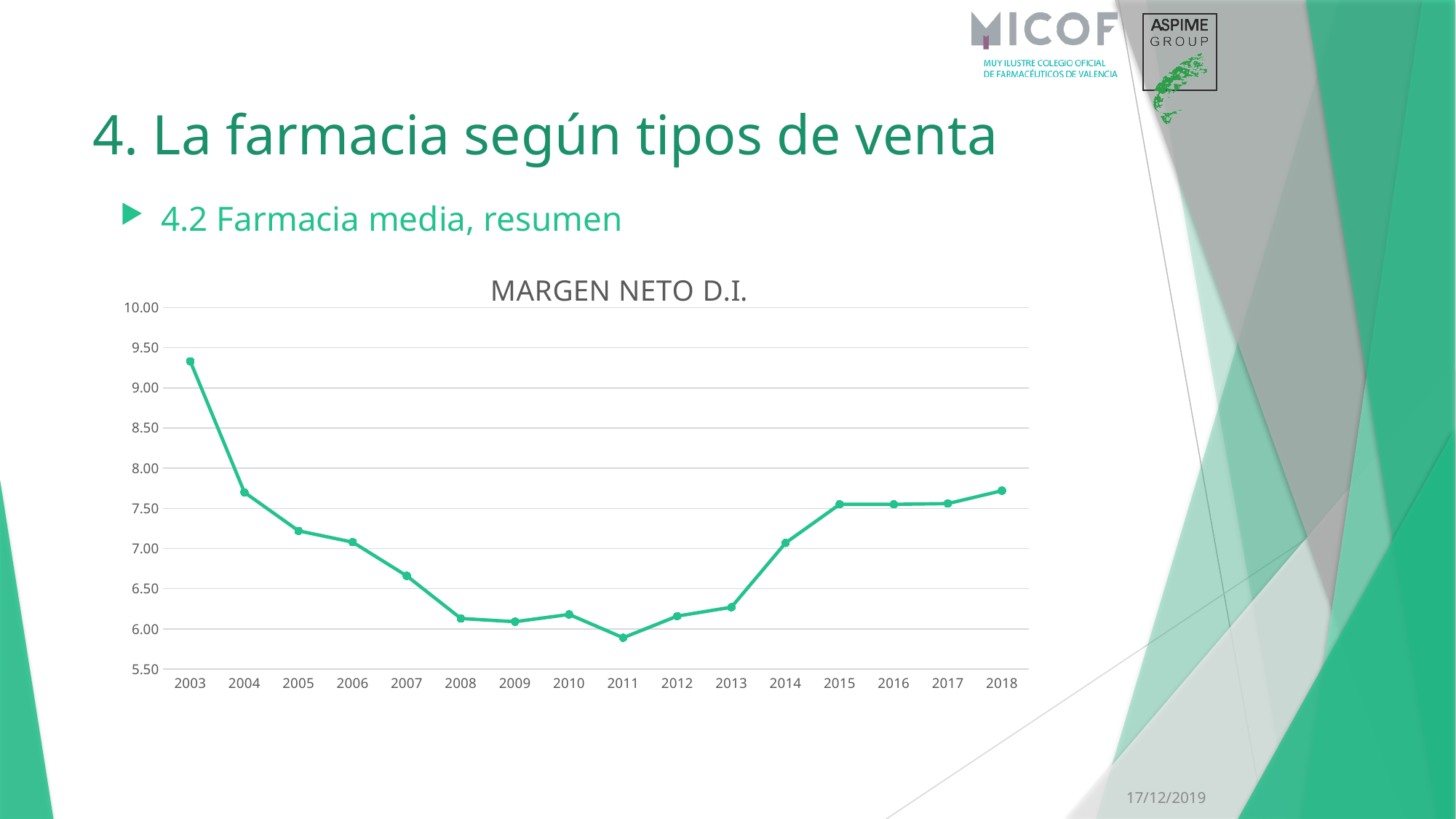
How many years are plotted on the x axis of the chart? 16 Is the value for 2003 greater or less than 9.00? greater What kind of chart is shown on the slide? line chart Which year has the larger value, 2009 or 2013? 2013 Which year has the lowest value in the chart? 2011 Do the values rise or fall from 2003 to 2008? fall What is the title of the chart? MARGEN NETO D.I. Which year has the larger value, 2003 or 2018? 2003 Is the value for 2004 greater or less than 8.00? less Which year has the highest value in the chart? 2003 Is the value for 2008 greater or less than 6.50? less